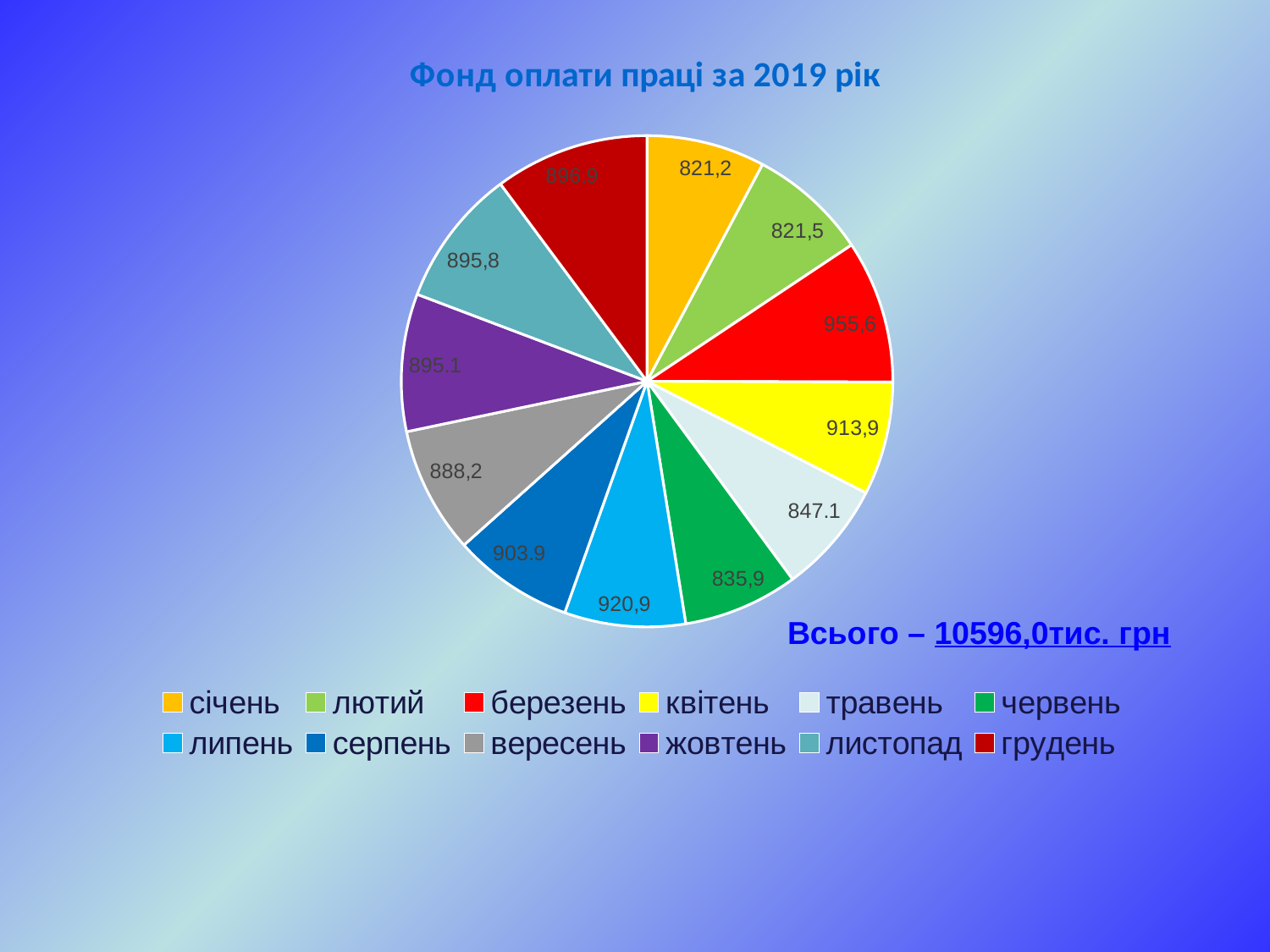
What is the value for травень? 847.1 What is the value for вересень? 888,2 What total is stated on the slide for the whole year? 10596,0 тис. грн How many slices (months) does the pie chart have? 12 How many entries does the legend list? 12 What is the value for липень? 920,9 Which month has the highest value? березень What is the value for березень? 955,6 What is the title of the chart? Фонд оплати праці за 2019 рік What type of chart is shown on the slide? pie chart Which is larger, the value for липень or the value for червень? липень What is the difference between the values for березень and січень? 134,4